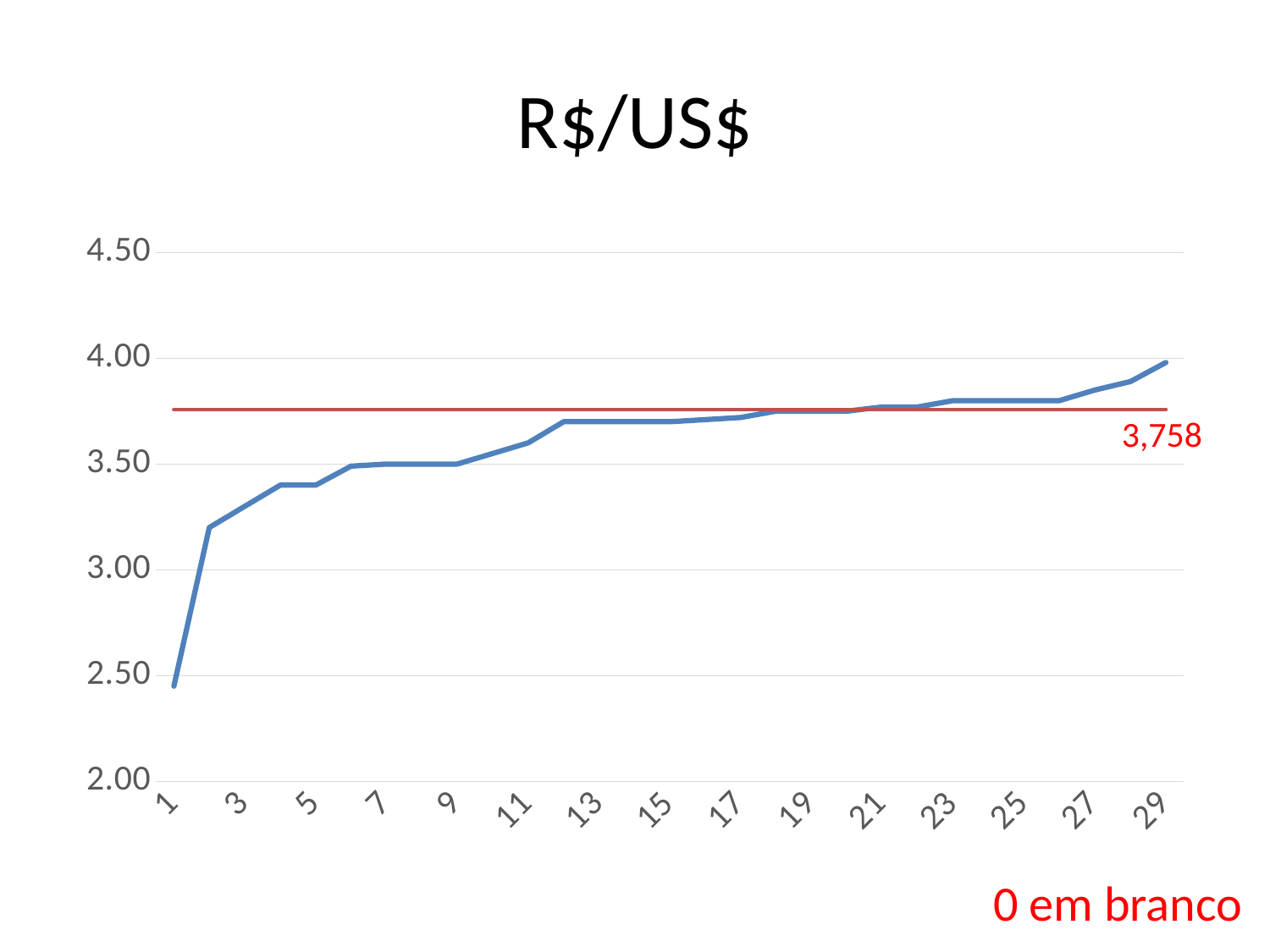
Does the blue line generally rise or fall from left to right along the x axis? rise Is the value at point 29 greater or less than 3.50? greater Is the value at point 1 greater or less than 3.00? less Is the value at point 13 greater or less than 3.50? greater What value is labelled on the red horizontal reference line? 3,758 What is the title of the chart? R$/US$ At which x-axis point is the blue line at its highest value? 29 What kind of chart is shown on the slide? line chart What text in red appears at the bottom right of the slide? 0 em branco Which has the larger value, point 5 or point 13? 13 At which x-axis point is the blue line at its lowest value? 1